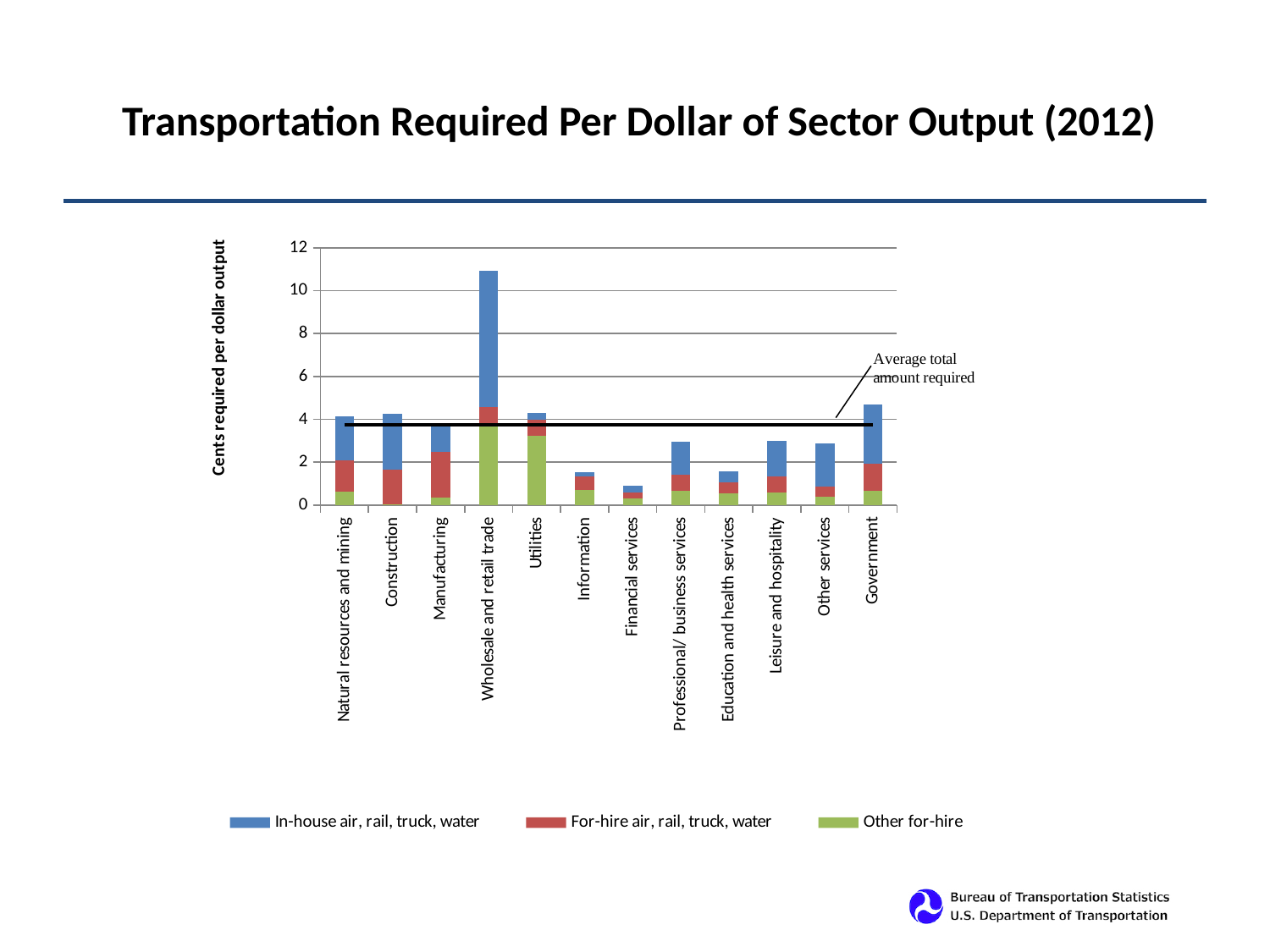
What does the black horizontal line across the chart represent? Average total amount required Is the total value for Professional/ business services greater or less than 4? less Is the total value for Government greater or less than 4? greater Is the total value for Wholesale and retail trade greater or less than 10? greater What kind of chart is shown on the slide? Stacked bar chart How many sectors (categories) are plotted along the x axis? 12 Which has a larger total, Information or Financial services? Information How many series does the legend list? 3 Which sector has the lowest total cents required per dollar output? Financial services Which sector has the highest total cents required per dollar output? Wholesale and retail trade What is the title of the chart? Transportation Required Per Dollar of Sector Output (2012)